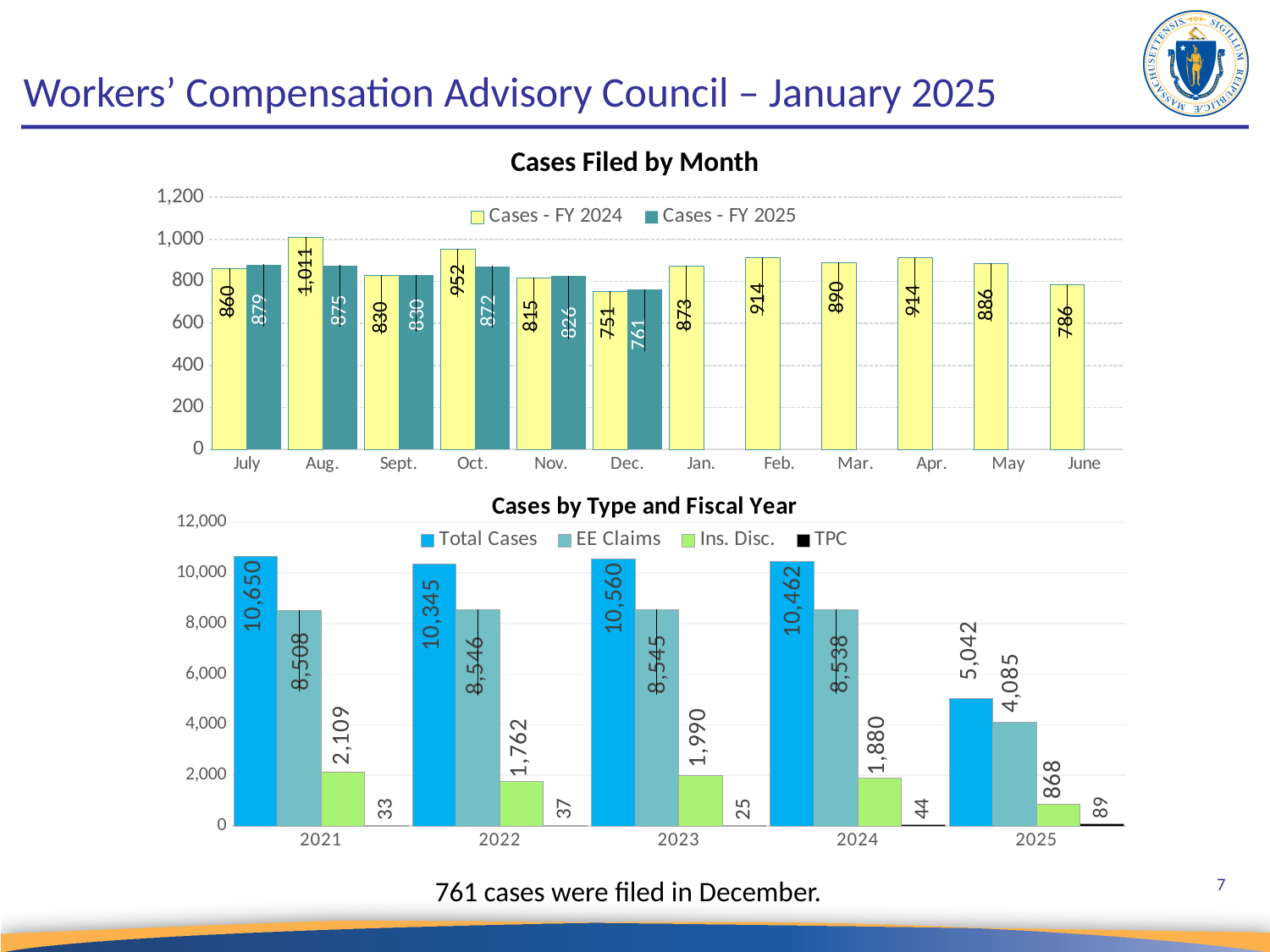
What kind of chart is 'Cases by Type and Fiscal Year'? Bar chart In the 'Cases Filed by Month' chart, what is the value for Cases - FY 2025 in December? 761 In the 'Cases by Type and Fiscal Year' chart, what is the value of TPC for 2025? 89 In the 'Cases by Type and Fiscal Year' chart, how many series does the legend list? 4 In the 'Cases Filed by Month' chart, what is the difference between Cases - FY 2024 and Cases - FY 2025 in October? 80 In the 'Cases by Type and Fiscal Year' chart, which year has the highest Total Cases? 2021 In the 'Cases by Type and Fiscal Year' chart, which is larger: Ins. Disc. for 2021 or Ins. Disc. for 2023? Ins. Disc. for 2021 In the 'Cases by Type and Fiscal Year' chart, what is the value of Total Cases for 2023? 10,560 In the 'Cases Filed by Month' chart, what is the value for Cases - FY 2024 in August? 1,011 In the 'Cases Filed by Month' chart, how many series does the legend list? 2 In the 'Cases Filed by Month' chart, which month has the highest value for Cases - FY 2024? Aug. In the 'Cases Filed by Month' chart, which month has the lowest value for Cases - FY 2024? Dec.